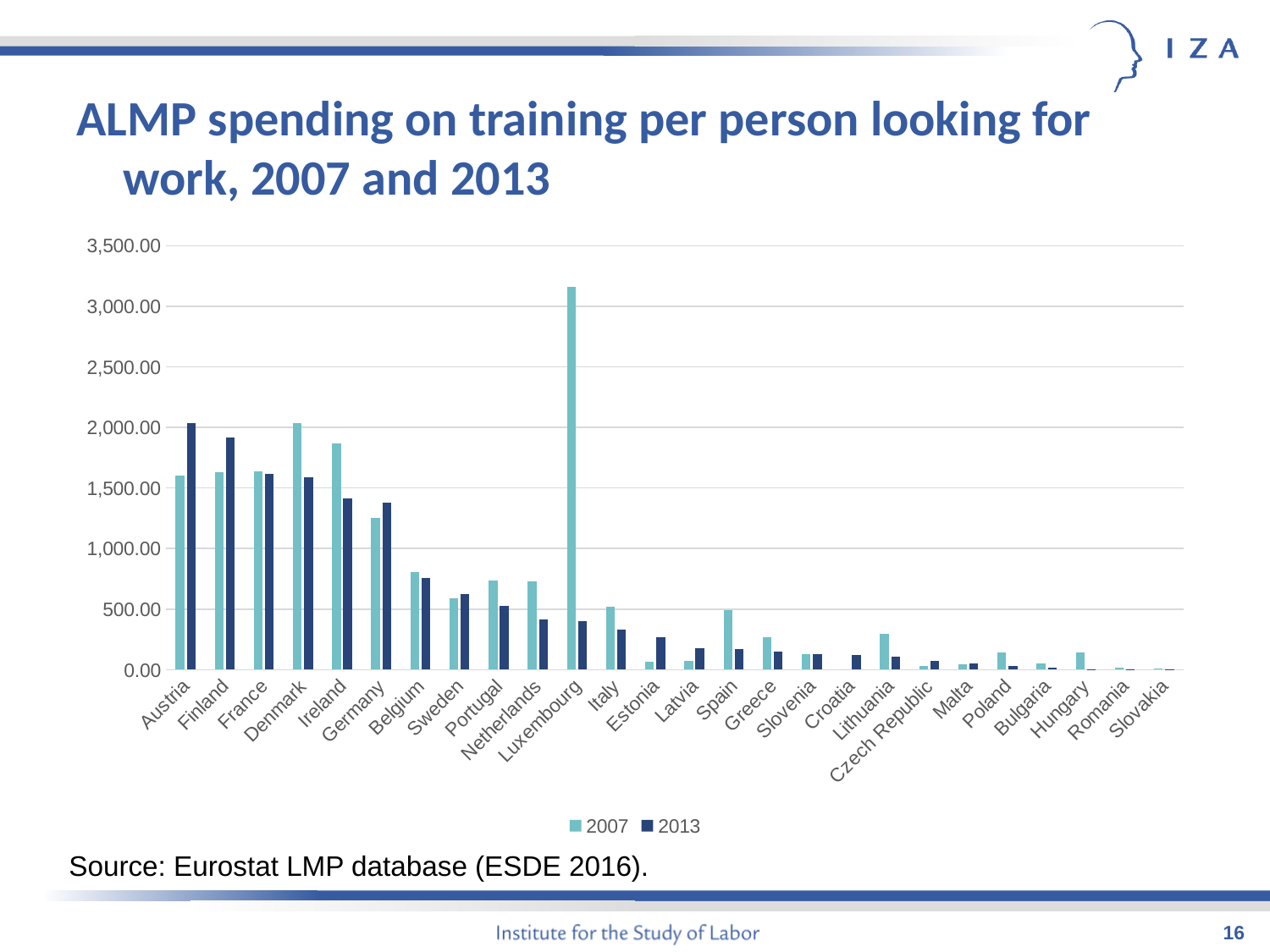
How many series does the legend list? 2 For Luxembourg, which is larger: the 2007 value or the 2013 value? 2007 How many countries are shown on the x axis? 26 Is the 2013 value for the Netherlands greater or less than 500.00? less For Austria, which is larger: the 2007 value or the 2013 value? 2013 Is the 2007 value for Germany greater or less than 1,000.00? greater Is the 2013 value for Finland greater or less than 1,500.00? greater Which country has the highest 2013 value? Austria Which series are listed in the legend? 2007 and 2013 Which country has the highest 2007 value? Luxembourg What kind of chart is shown on the slide? bar chart